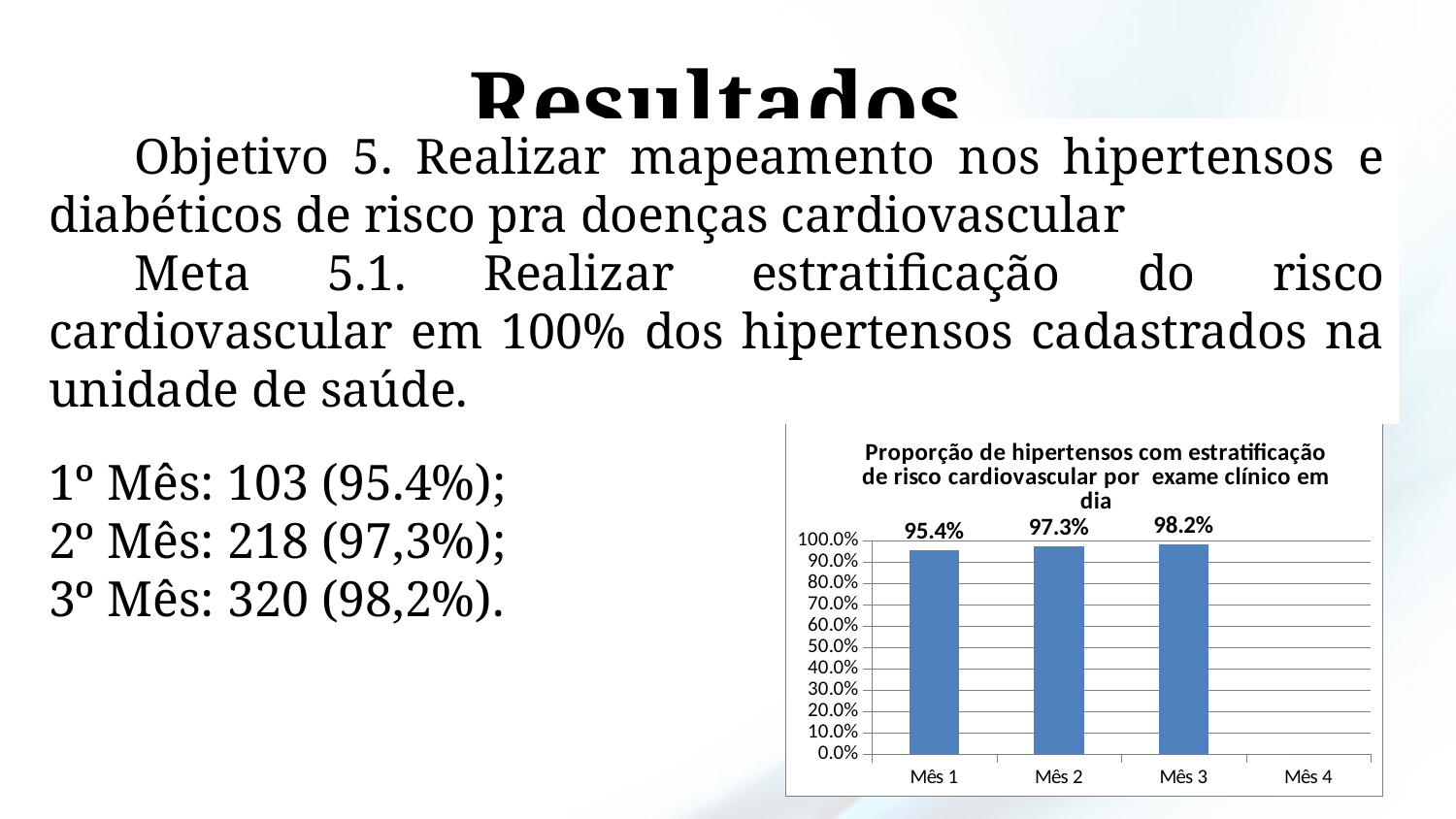
What is the value for Mês 3 in the chart? 98.2% Is the value for Mês 1 greater or less than 90.0%? greater What is the difference between the values for Mês 3 and Mês 1? 2.8 percentage points What kind of chart is shown on the slide? Bar chart Which of the plotted months has the lowest value in the chart? Mês 1 Do the values rise or fall from Mês 1 to Mês 3? Rise How many bars are plotted in the chart? 3 What is the difference between the values for Mês 2 and Mês 1? 1.9 percentage points What is the value for Mês 2 in the chart? 97.3% Which is larger, the value for Mês 2 or the value for Mês 3? Mês 3 Which month has the highest value in the chart? Mês 3 What is the value for Mês 1 in the chart? 95.4%